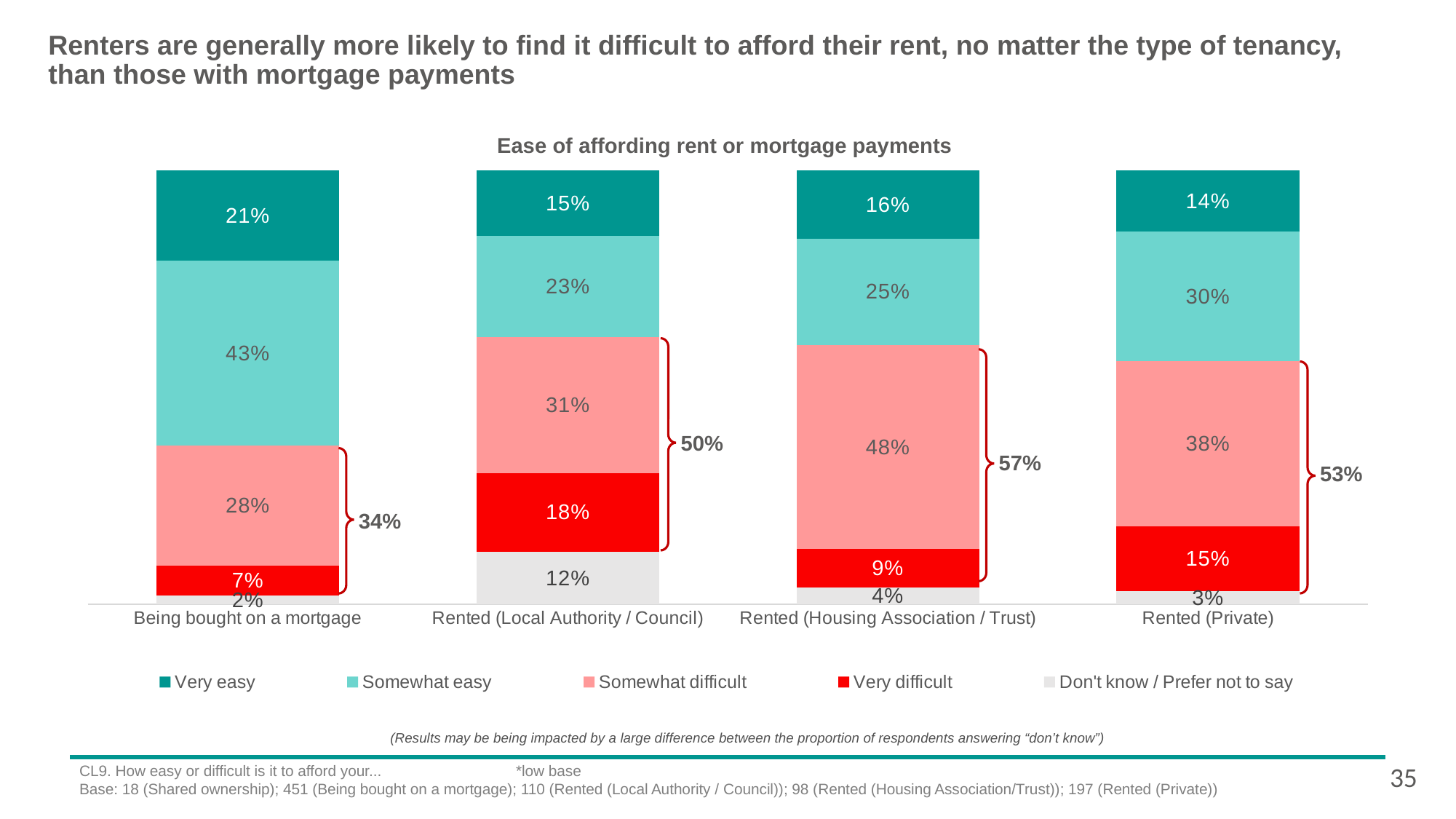
What is the combined 'Somewhat difficult' and 'Very difficult' percentage for 'Rented (Housing Association / Trust)'? 57% How many series does the chart legend list? 5 What percentage of respondents in the 'Rented (Private)' category said it is very easy to afford their payments? 14% How many percentage points higher is the 'Very difficult' value for 'Rented (Private)' than for 'Being bought on a mortgage'? 8 percentage points Which has a larger 'Somewhat easy' value: 'Being bought on a mortgage' or 'Rented (Private)'? Being bought on a mortgage What is the title of the chart? Ease of affording rent or mortgage payments What type of chart is shown on the slide? Stacked bar chart What is the 'Somewhat difficult' value for 'Rented (Housing Association / Trust)'? 48% How many tenancy categories are shown on the x axis of the chart? 4 Which tenancy type has the lowest 'Somewhat easy' percentage? Rented (Local Authority / Council) What share of 'Rented (Local Authority / Council)' respondents answered 'Don't know / Prefer not to say'? 12% Which tenancy type has the highest 'Very difficult' percentage? Rented (Local Authority / Council)